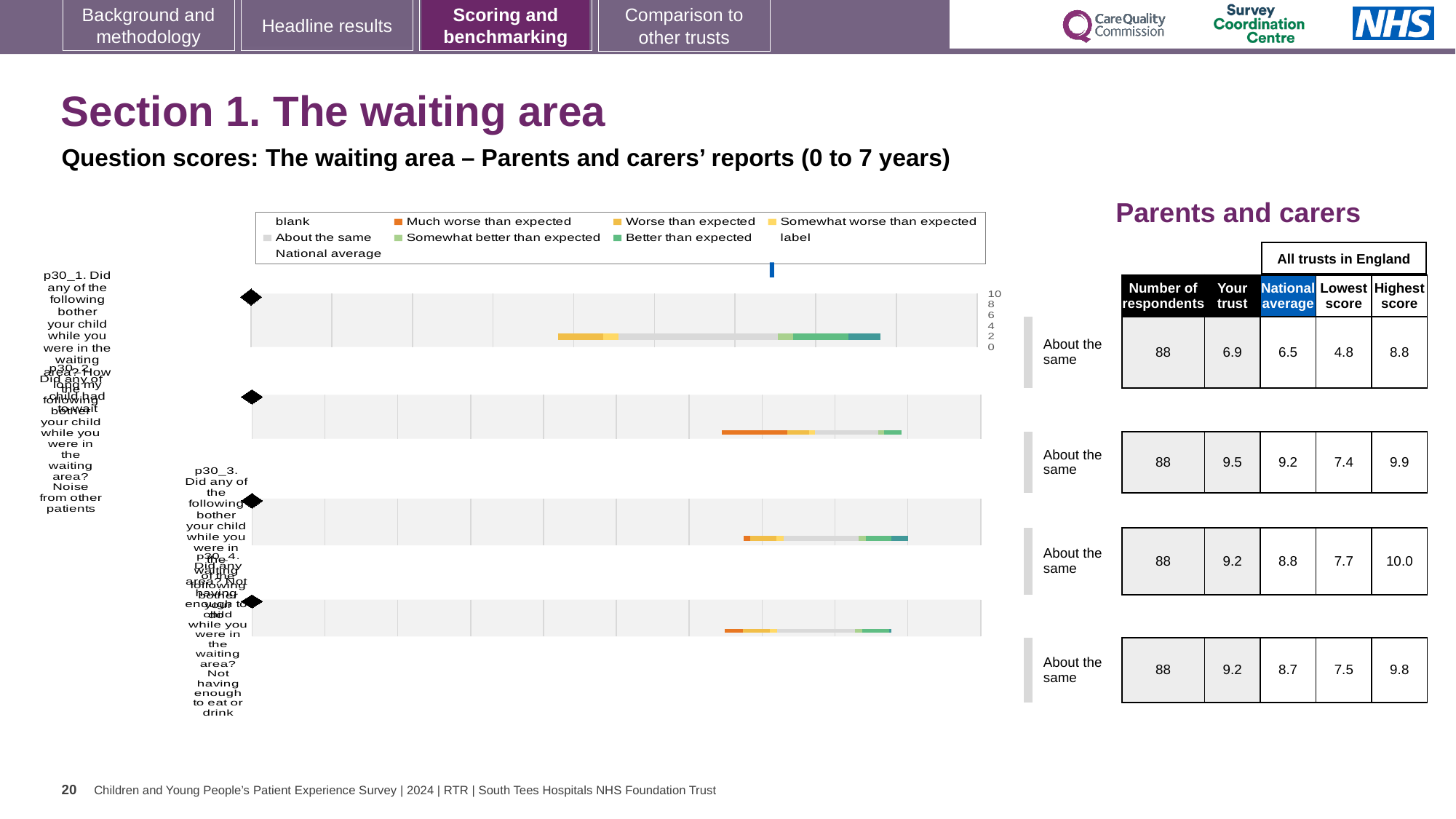
Which colour does the legend use for 'Much worse than expected'? orange In the table beside the chart, what is the 'Your trust' score for the first row (p30_1)? 6.9 How many horizontal bars (question rows) are plotted in the chart? 4 In the table beside the chart, what is the 'National average' for the second row (p30_2)? 9.2 In the table beside the chart, how many respondents are listed for each question row? 88 What kind of chart is shown on the slide? bar chart In the table beside the chart, what is the 'Highest score' for the third row (p30_3)? 10.0 In the table beside the chart, what is the difference between the 'Your trust' score and the 'National average' in the first row (p30_1)? 0.4 How many entries does the chart legend list? 9 Which legend entry is shown in light grey? About the same In the table beside the chart, which row has the lowest 'Your trust' score? the first row (p30_1) In the table beside the chart, what is the 'Lowest score' for the fourth row (p30_4)? 7.5